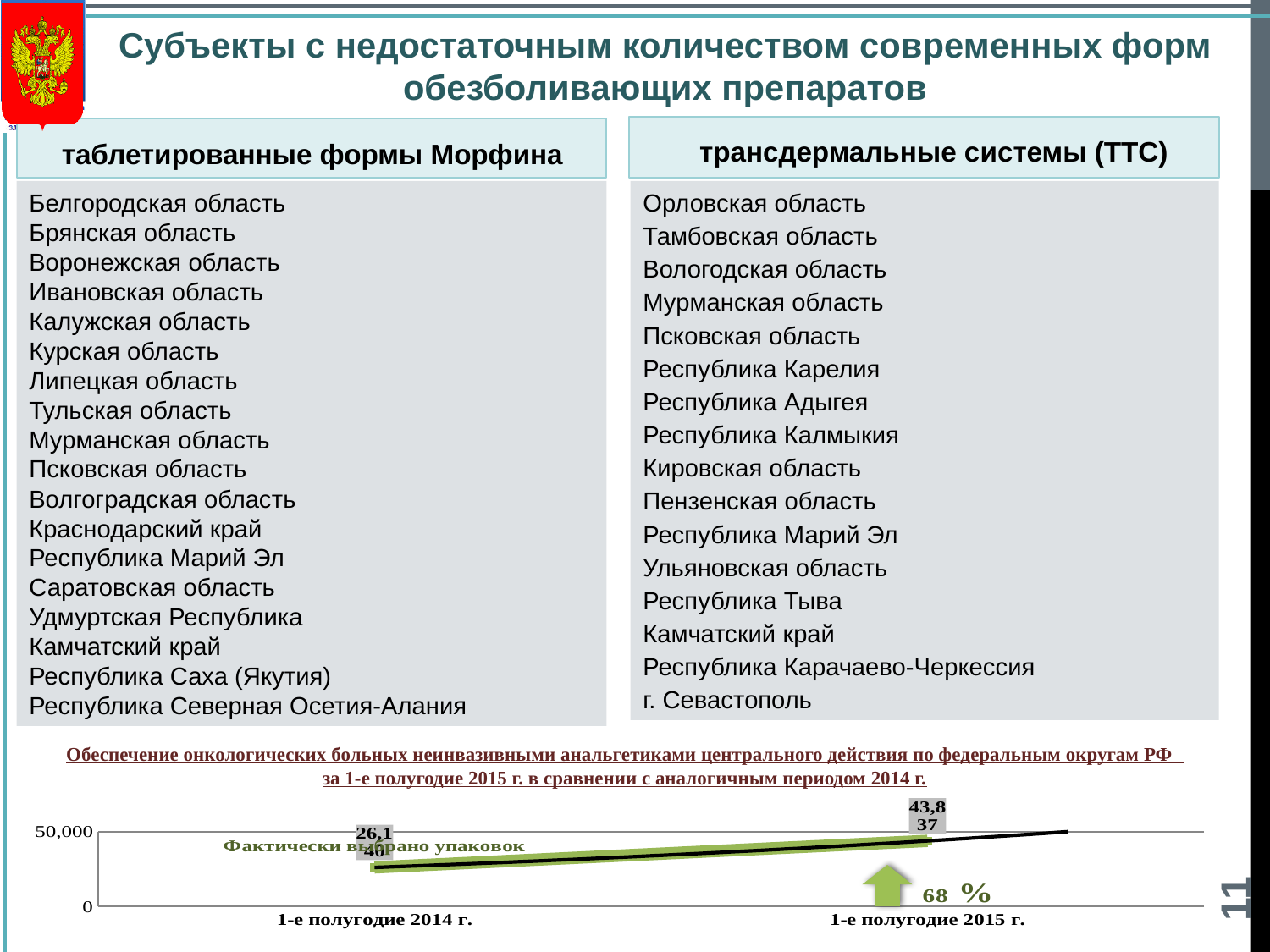
What is the second category on the x axis of the chart at the bottom of the slide? 1-е полугодие 2015 г. What is the topmost data label shown at 1-е полугодие 2015 г. in the chart at the bottom of the slide? 43,837 What kind of chart is shown at the bottom of the slide? line chart What is the topmost data label shown at 1-е полугодие 2014 г. in the chart at the bottom of the slide? 26,140 What percentage change is shown next to the green arrow in the chart at the bottom of the slide? 68 % How many periods are shown on the x axis of the chart at the bottom of the slide? 2 What is the highest tick value shown on the y axis of the chart at the bottom of the slide? 50,000 Do the lines in the chart at the bottom of the slide rise or fall from 1-е полугодие 2014 г. to 1-е полугодие 2015 г.? rise What is the first category on the x axis of the chart at the bottom of the slide? 1-е полугодие 2014 г.